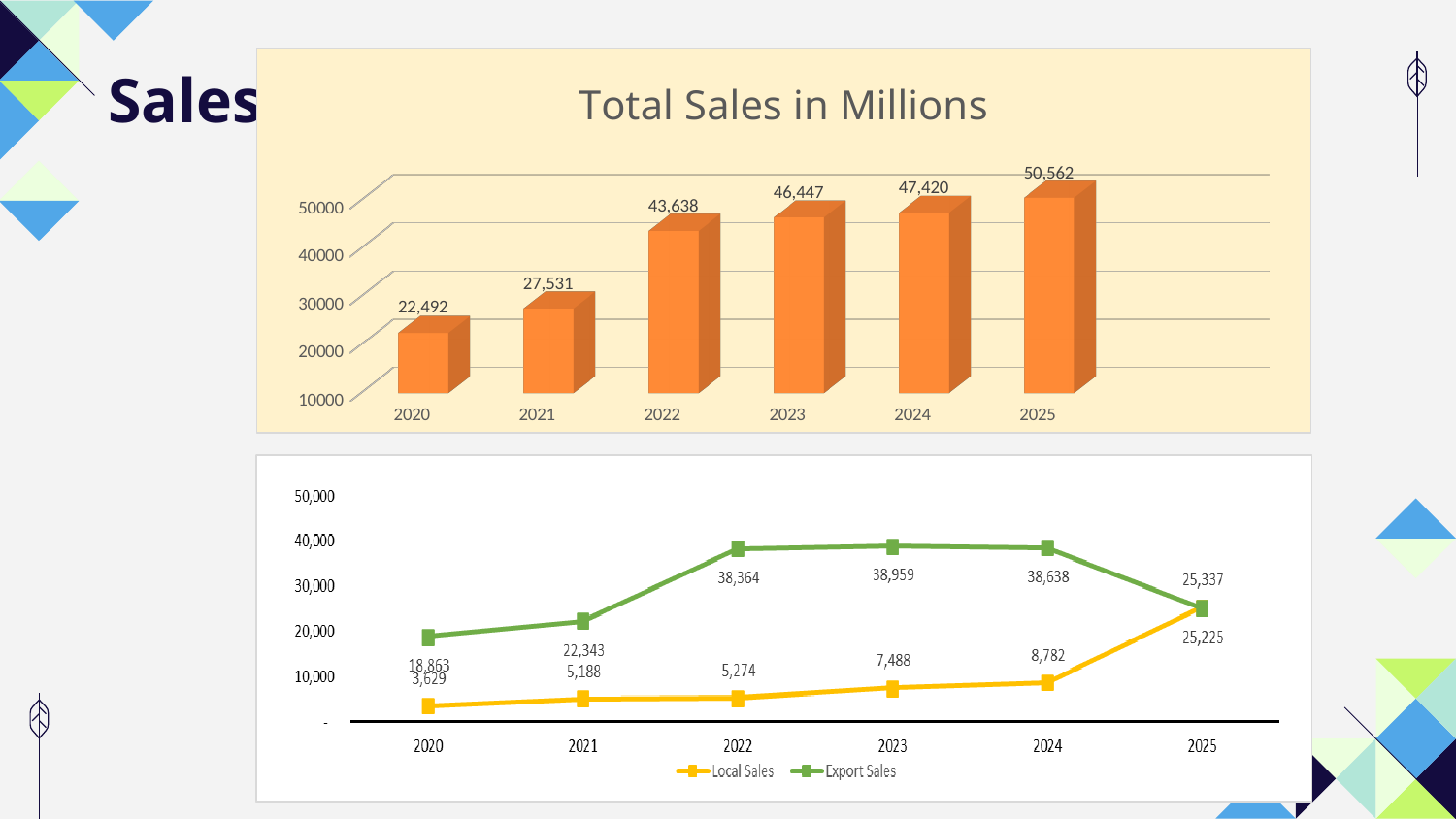
In the 'Total Sales in Millions' bar chart, how many years are shown? 6 In the 'Total Sales in Millions' bar chart, which year has the highest total sales? 2025 How many series does the legend of the bottom line chart list? 2 In the 'Total Sales in Millions' bar chart, what is the difference between the 2025 and 2020 values? 28,070 In the 'Total Sales in Millions' bar chart, do the values rise or fall from 2020 to 2025? Rise What kind of chart is the top chart titled 'Total Sales in Millions'? Bar chart In the bottom line chart, what is the Export Sales value for 2023? 38,959 In the bottom line chart, what is the Local Sales value for 2021? 5,188 In the 'Total Sales in Millions' bar chart, what is the value for 2022? 43,638 In the bottom line chart, which is larger in 2022: Local Sales or Export Sales? Export Sales In the bottom line chart, what is the difference between Export Sales and Local Sales in 2024? 29,856 In the 'Total Sales in Millions' bar chart, which year has the lowest total sales? 2020